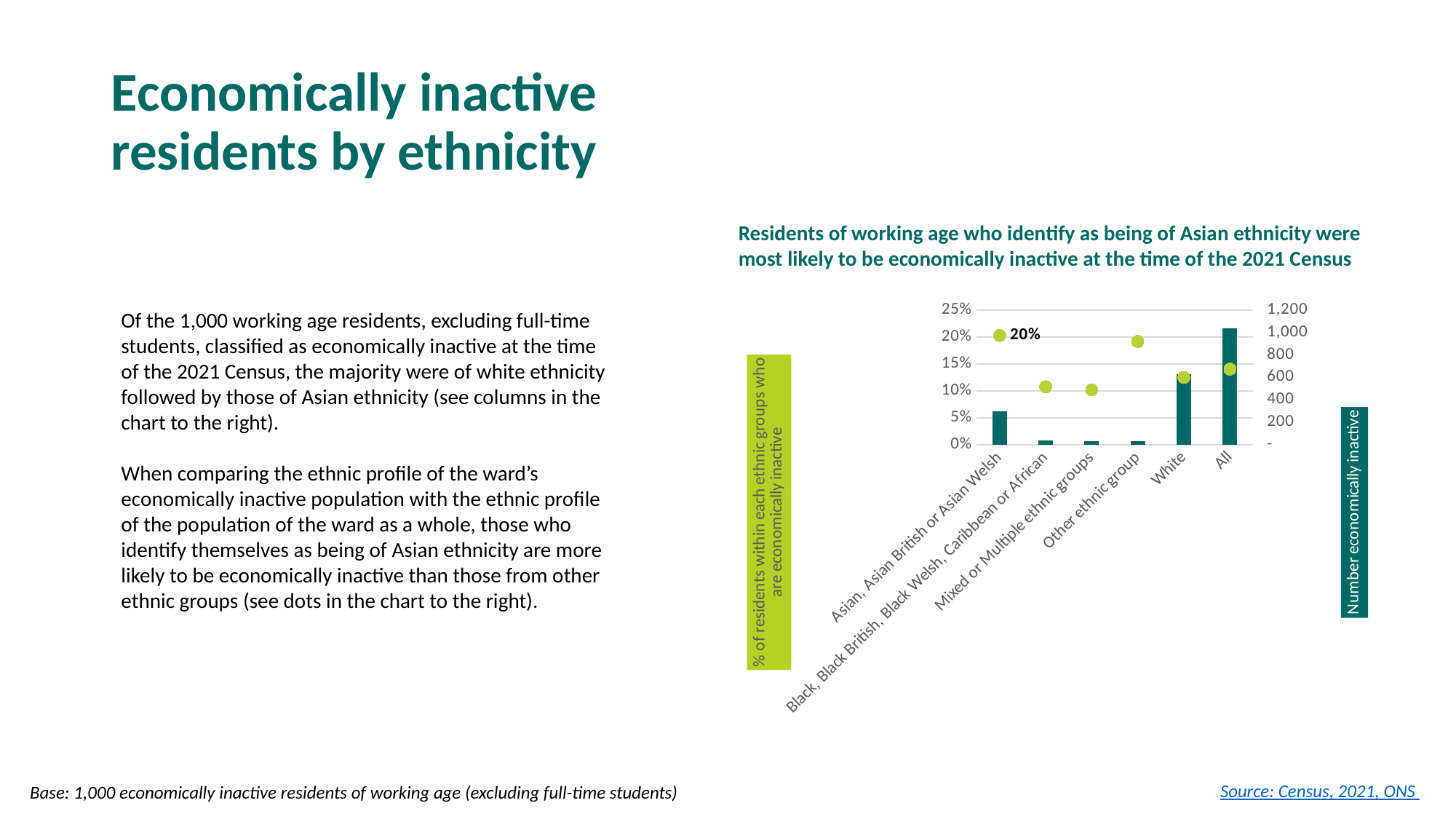
Which ethnic group has the highest percentage of residents who are economically inactive (the dots)? Asian, Asian British or Asian Welsh Is the number economically inactive for Asian, Asian British or Asian Welsh greater or less than 400? less Which category has the tallest bar for the number economically inactive? All What is the label of the right-hand vertical axis of the chart? Number economically inactive How many categories are shown along the x axis of the chart? 6 Is the percentage economically inactive for Mixed or Multiple ethnic groups greater or less than 15%? less Is the number economically inactive for All greater or less than 800? greater Which has the higher percentage of economically inactive residents: Other ethnic group or Black, Black British, Black Welsh, Caribbean or African? Other ethnic group What kind of chart is shown on the slide? Combination bar chart with dot markers Excluding the 'All' category, which ethnic group has the largest number of economically inactive residents? White What percentage of residents in the Asian, Asian British or Asian Welsh group are economically inactive? 20%